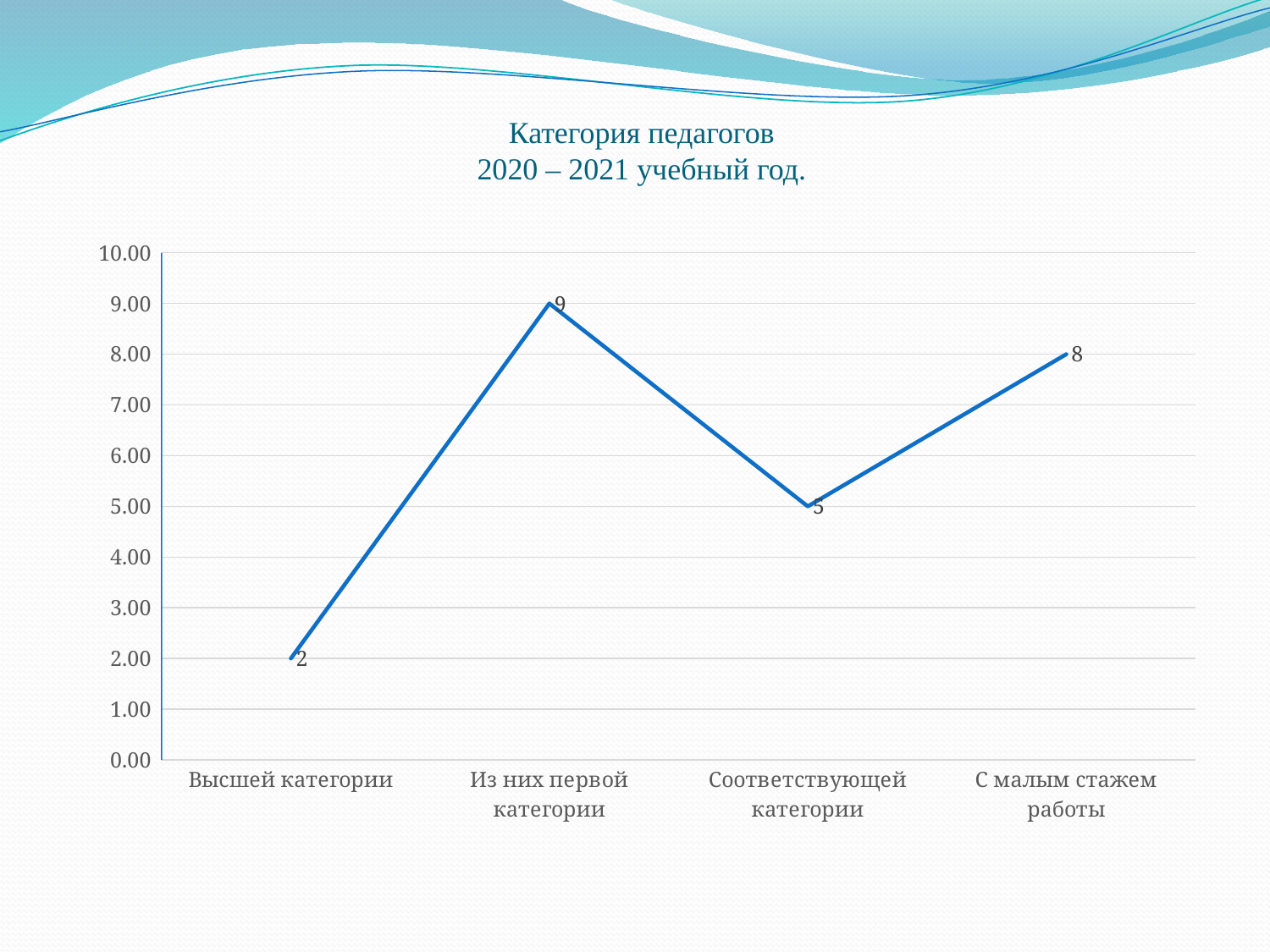
Which is larger, the value for Соответствующей категории or the value for С малым стажем работы? С малым стажем работы What is the value for Высшей категории? 2 Which category has the lowest value? Высшей категории Which category has the highest value? Из них первой категории What is the value for Соответствующей категории? 5 What is the value for С малым стажем работы? 8 What is the title of the chart? Категория педагогов 2020 – 2021 учебный год. How many categories are plotted on the x axis? 4 What is the difference between the values for Из них первой категории and Высшей категории? 7 What kind of chart is shown on the slide? line chart What is the value for Из них первой категории? 9 What is the difference between the values for С малым стажем работы and Соответствующей категории? 3